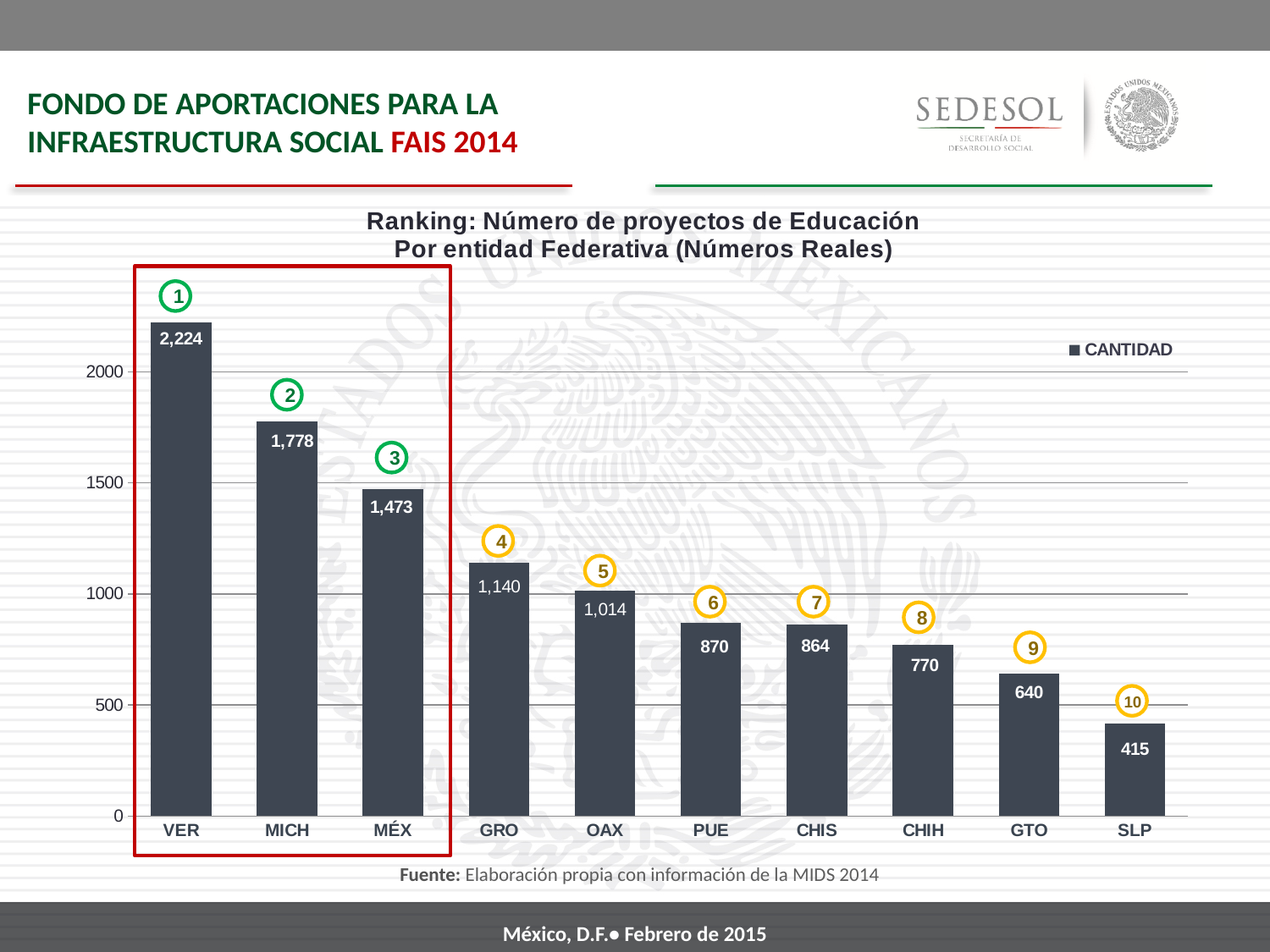
What is the value for CHIH? 770 How many entities are shown on the x axis? 10 What is the value for OAX? 1,014 What is the difference between the values for VER and MICH? 446 Which is larger, the value for MÉX or the value for GRO? MÉX How many series does the legend list? 1 Do the values rise or fall from left to right along the x axis? fall Which entity has the highest number of education projects? VER What is the difference between the values for GTO and SLP? 225 Which entity has the lowest number of education projects? SLP What is the value for VER? 2,224 What kind of chart is shown? bar chart